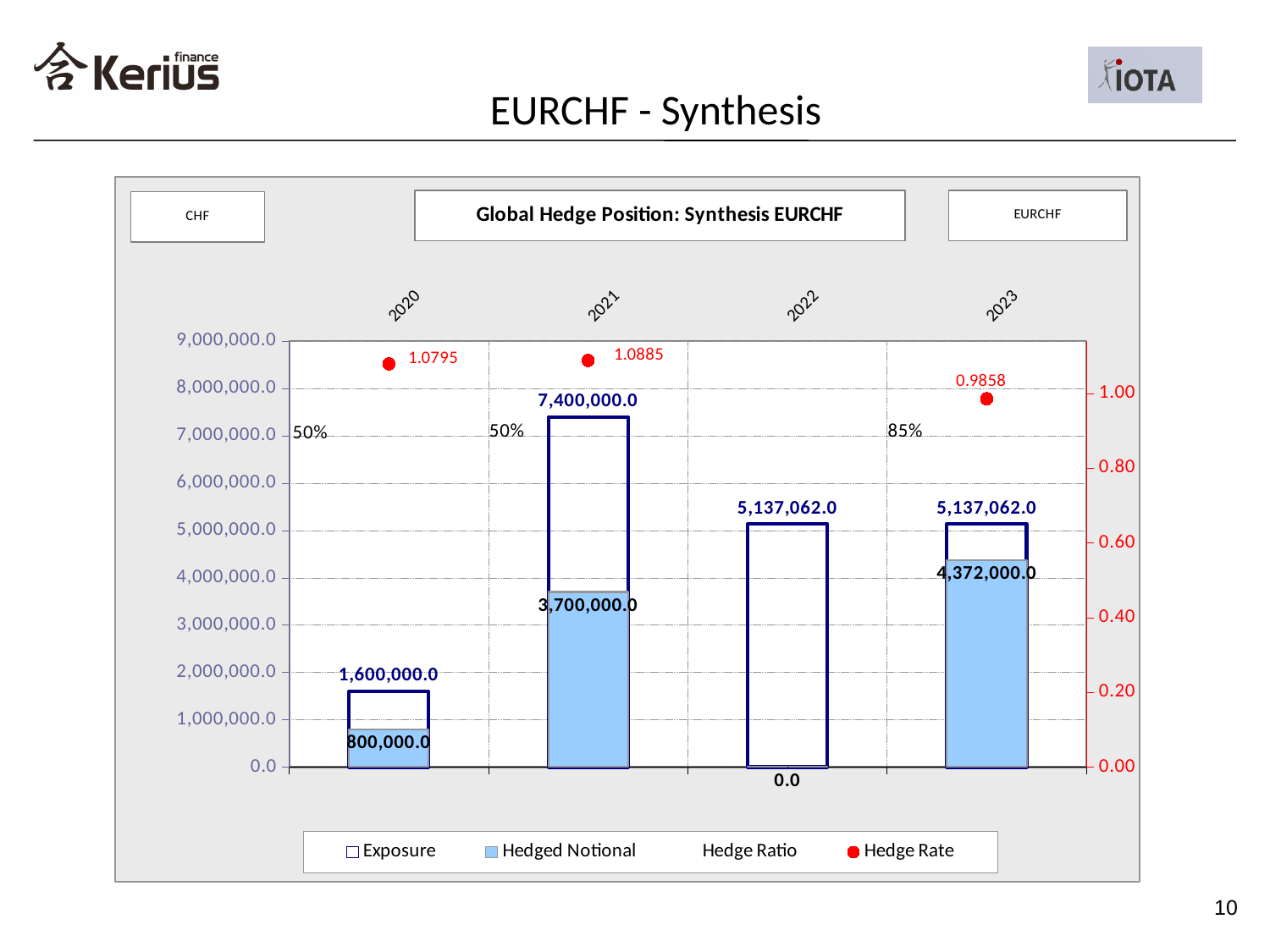
What is the title of the chart? Global Hedge Position: Synthesis EURCHF Which year has the lowest Hedged Notional? 2022 Which year has the highest Exposure? 2021 What is the Exposure value for 2021? 7,400,000.0 What is the Hedged Notional value for 2023? 4,372,000.0 What is the Hedge Ratio shown for 2023? 85% What is the Hedge Rate shown for 2020? 1.0795 How many series does the legend list? 4 How many years are shown on the x axis? 4 What type of chart is used to show Exposure and Hedged Notional? Bar chart What is the difference between the Exposure and the Hedged Notional in 2021? 3,700,000.0 Which is larger, the Hedged Notional for 2023 or the Hedged Notional for 2021? 2023